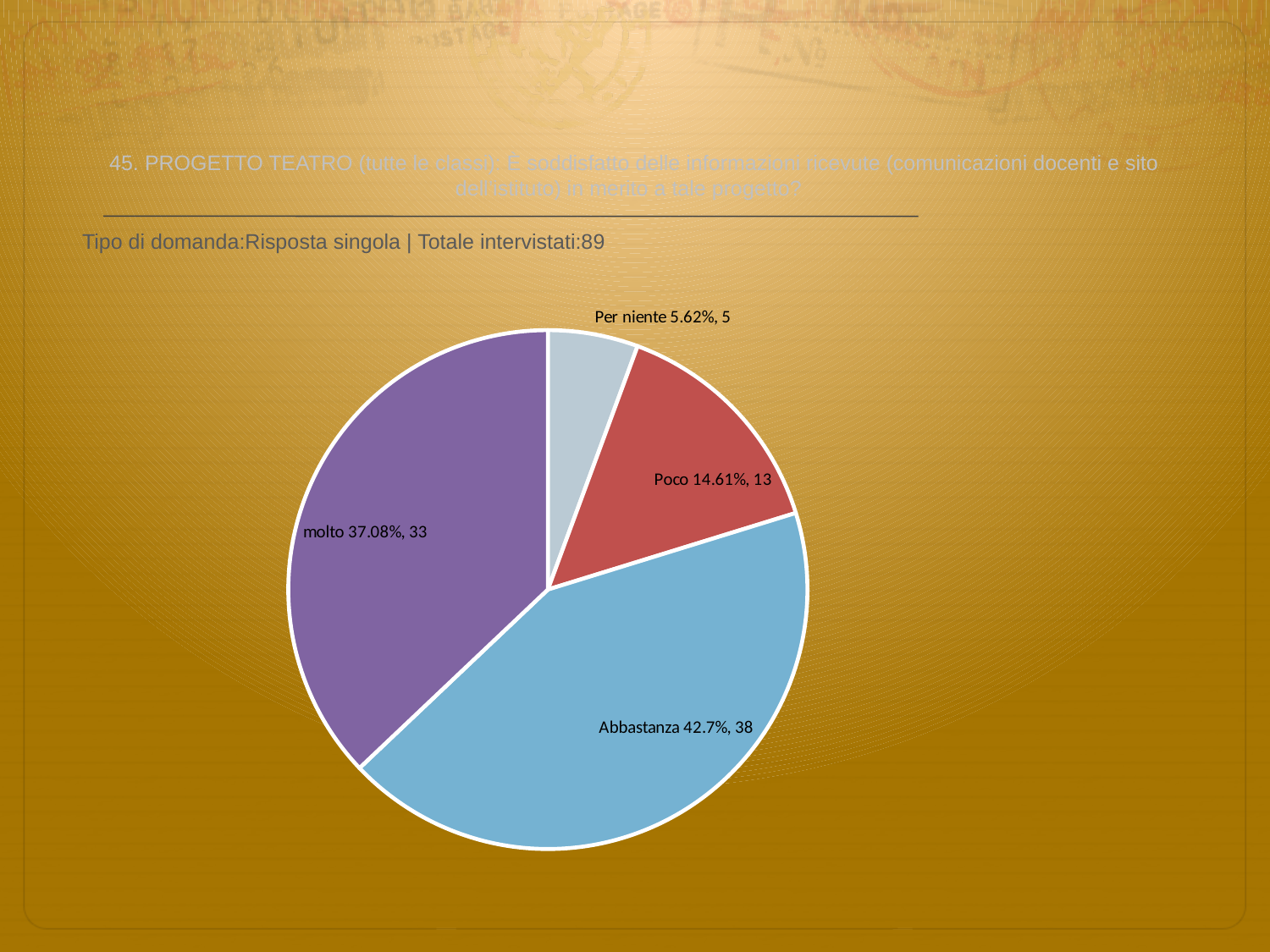
What is the difference in respondent count between Abbastanza and molto? 5 What colour is the Abbastanza slice? light blue What is the total number of respondents (Totale intervistati) stated on the slide? 89 Which category has the smallest slice? Per niente How many respondents answered Per niente? 5 What percentage is shown for the Abbastanza slice? 42.7% Which category has the largest slice? Abbastanza How many slices does the pie chart have? 4 What percentage is shown for the Poco slice? 14.61% Which has more respondents, Poco or Per niente? Poco What kind of chart is shown on the slide? pie chart How many respondents answered molto? 33